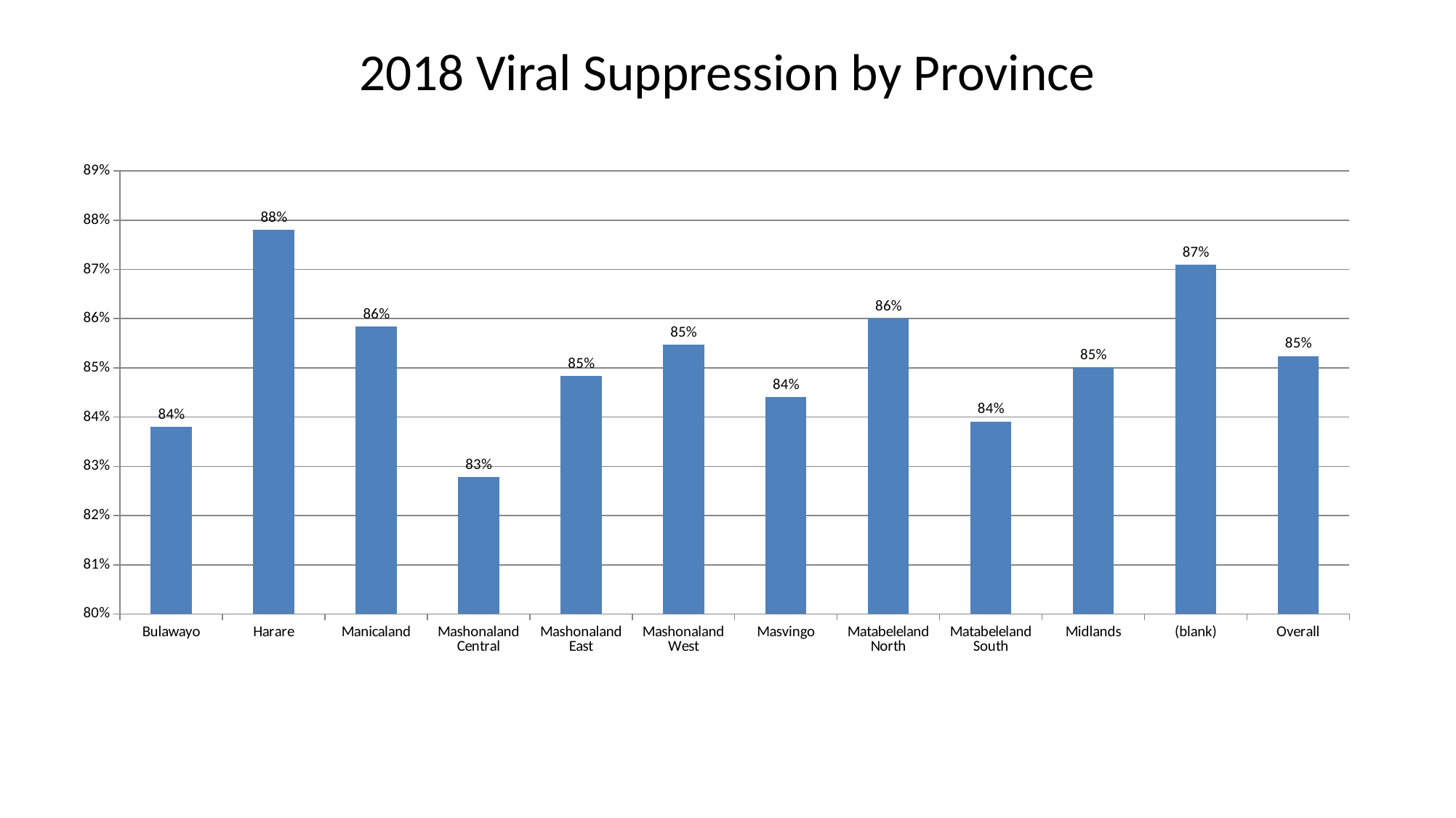
How many categories are shown on the x axis of the chart? 12 What is the title of the chart? 2018 Viral Suppression by Province What is the viral suppression value shown for Harare? 88% Which province has the lowest viral suppression value? Mashonaland Central What kind of chart is shown on the slide? Bar chart Which province has the highest viral suppression value? Harare Which has a larger viral suppression value, Harare or Bulawayo? Harare What is the difference between the labelled values for Harare and Mashonaland Central? 5% What is the viral suppression value shown for Mashonaland Central? 83% What value is labelled for the (blank) category? 87% What is the Overall viral suppression value shown on the chart? 85%